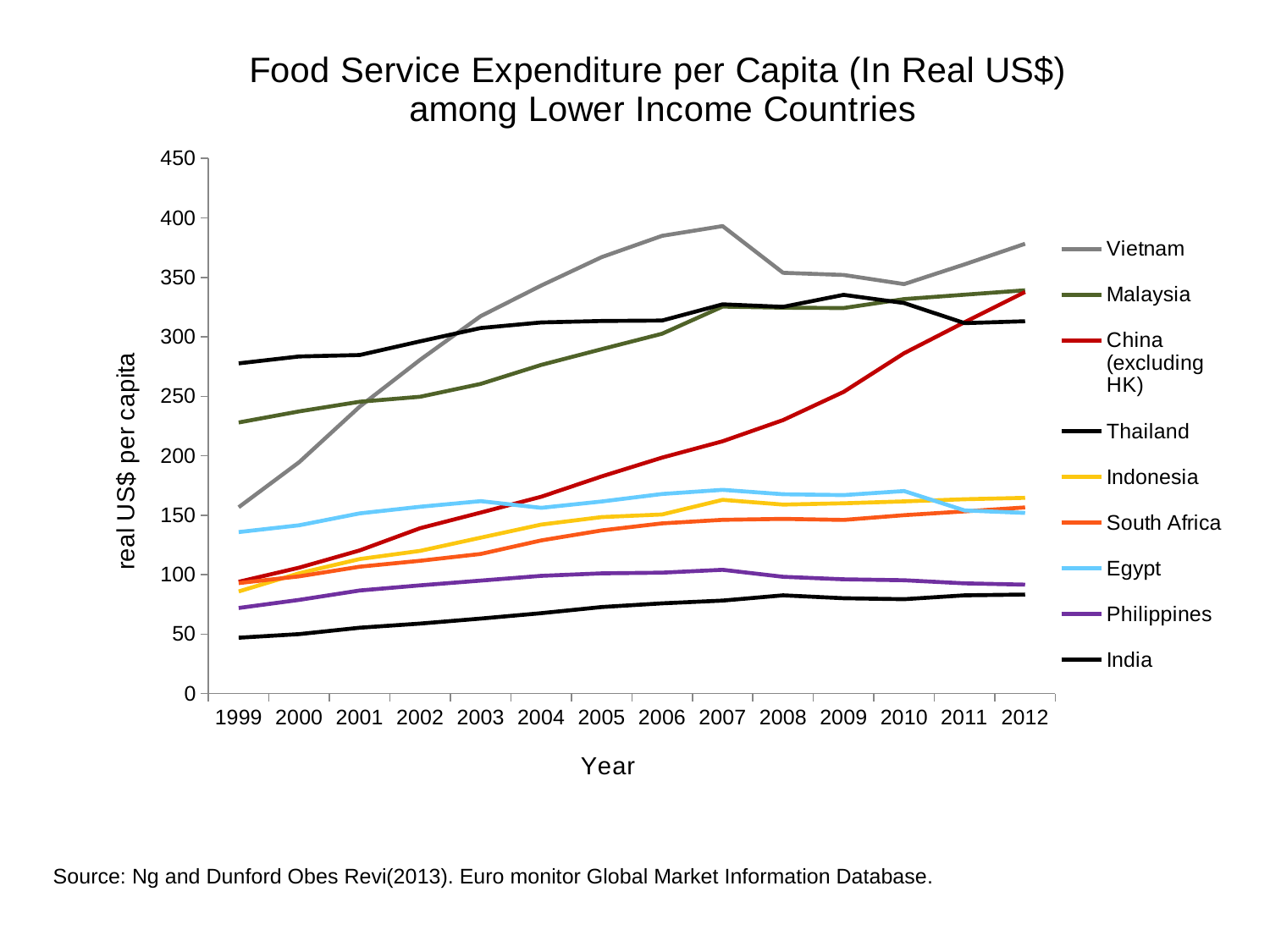
Does the line for China (excluding HK) rise or fall from 1999 to 2012? rise Is the value for Vietnam in 2007 greater or less than 350? greater Which country has the lowest food service expenditure per capita in 1999? India In 1999, which is larger: the value for Thailand or the value for Malaysia? Thailand Is the value for India in 2012 greater or less than 100? less Is the value for Malaysia in 2012 greater or less than 300? greater In 2012, which is larger: the value for China (excluding HK) or the value for Egypt? China (excluding HK) What is the label on the y axis of the chart? real US$ per capita How many countries (series) does the legend list? 9 What kind of chart is shown on the slide? line chart How many years are plotted along the x axis? 14 Which country has the highest food service expenditure per capita in 2012? Vietnam